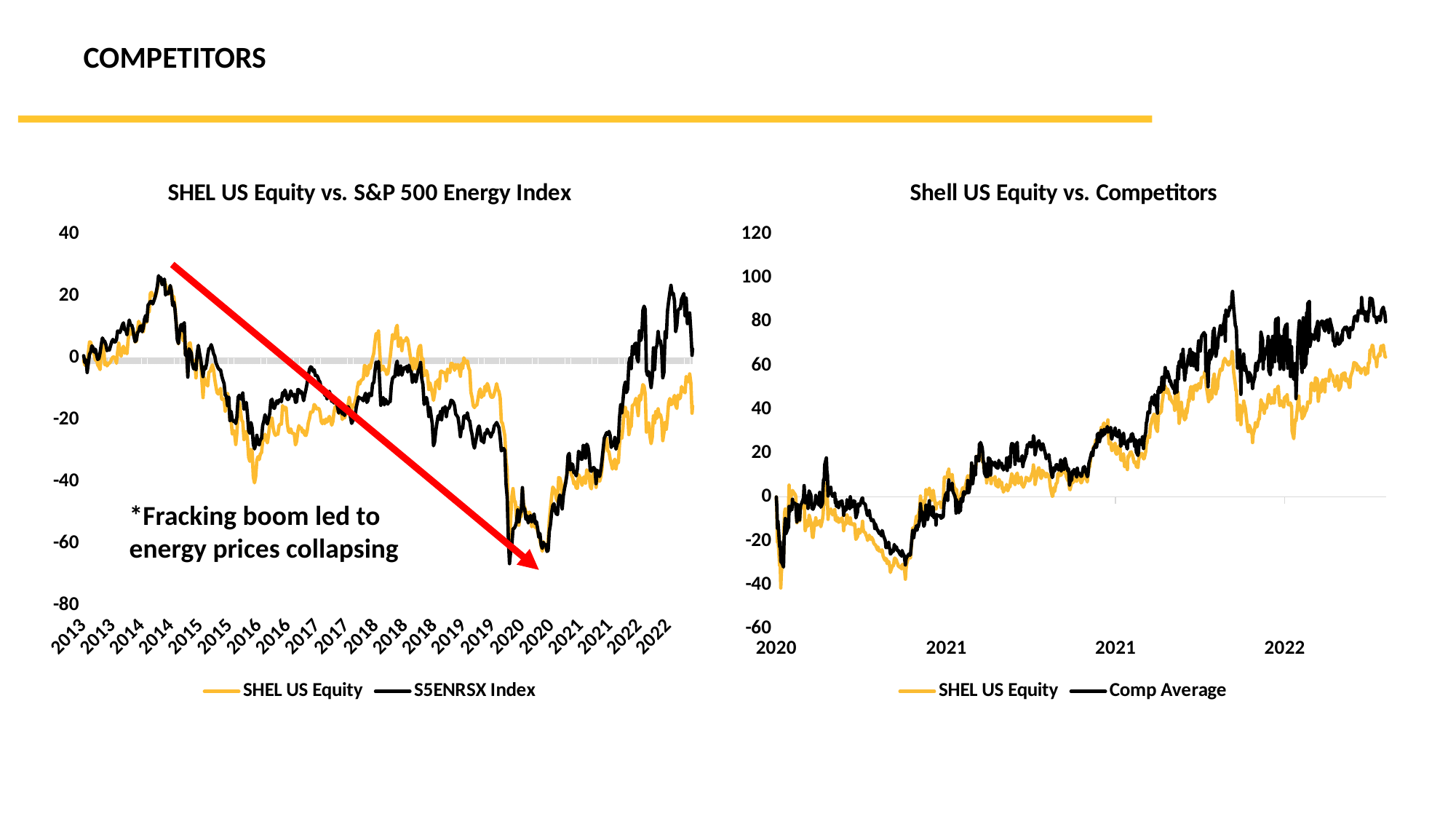
In the 'SHEL US Equity vs. S&P 500 Energy Index' chart, is the lowest value of the S5ENRSX Index in 2020 greater or less than -60? less What kind of chart is the 'Shell US Equity vs. Competitors' chart on the right? Line chart How many series does the legend of the 'SHEL US Equity vs. S&P 500 Energy Index' chart list? 2 How many series does the legend of the 'Shell US Equity vs. Competitors' chart list? 2 In the 'Shell US Equity vs. Competitors' chart, do the values generally rise or fall from 2020 to 2022? Rise In the 'Shell US Equity vs. Competitors' chart, what is the name of the series plotted in black? Comp Average In the 'Shell US Equity vs. Competitors' chart, is the Comp Average value at the end of 2022 greater or less than 60? greater In the 'SHEL US Equity vs. S&P 500 Energy Index' chart, which series is higher at the end of 2022, SHEL US Equity or S5ENRSX Index? S5ENRSX Index In the 'SHEL US Equity vs. S&P 500 Energy Index' chart, what is the name of the series plotted in black? S5ENRSX Index In the 'SHEL US Equity vs. S&P 500 Energy Index' chart, is the peak value of the S5ENRSX Index in 2022 greater or less than 20? greater What kind of chart is the 'SHEL US Equity vs. S&P 500 Energy Index' chart on the left? Line chart In the 'Shell US Equity vs. Competitors' chart, which series is higher at the end of 2022, SHEL US Equity or Comp Average? Comp Average